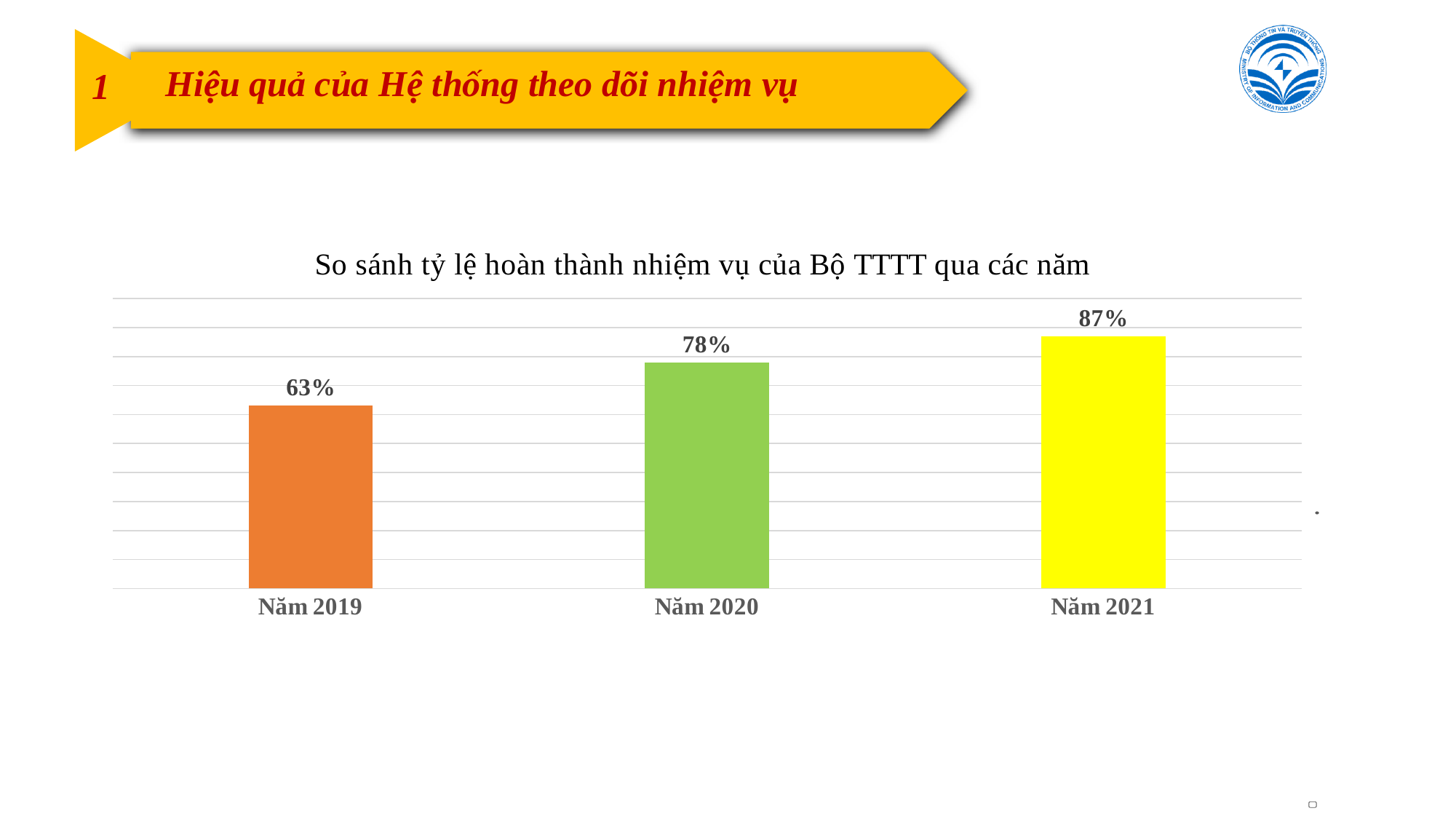
Which year has the lowest value? Năm 2019 What is the difference between the values for Năm 2021 and Năm 2019? 24% What kind of chart is shown on the slide? Bar chart What is the value for Năm 2020? 78% Which year has the highest value? Năm 2021 Which is larger, the value for Năm 2020 or the value for Năm 2021? Năm 2021 Do the values rise or fall from Năm 2019 to Năm 2021? Rise What is the value for Năm 2019? 63% How many years are shown on the chart? 3 What is the difference between the values for Năm 2020 and Năm 2019? 15% What is the value for Năm 2021? 87% What is the title of the chart? So sánh tỷ lệ hoàn thành nhiệm vụ của Bộ TTTT qua các năm